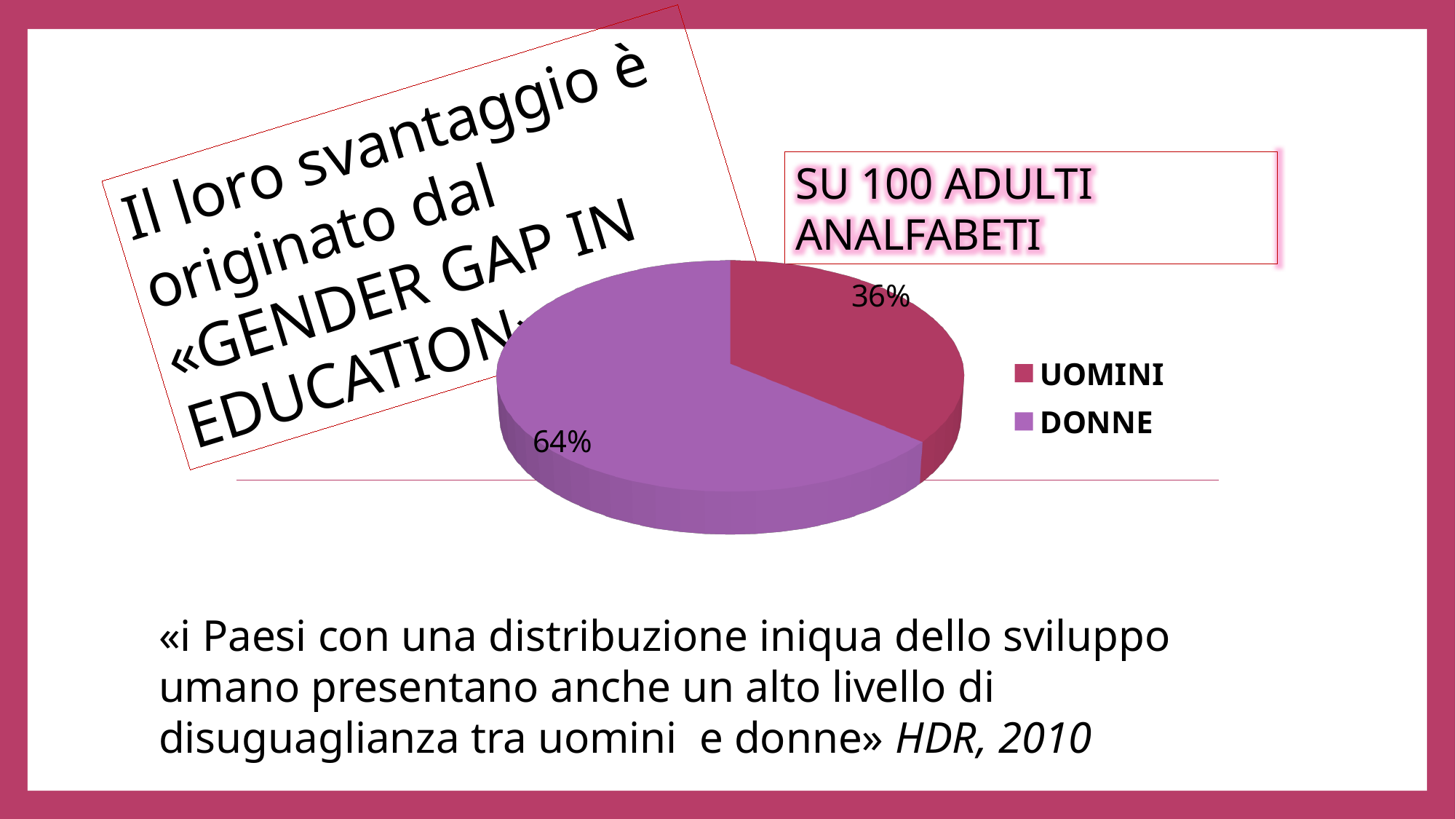
Which slice is larger, UOMINI or DONNE? DONNE How many categories does the pie chart show? 2 What percentage of the pie chart is labelled DONNE? 64% Which category has the largest slice of the pie chart? DONNE What is the title shown above the pie chart? SU 100 ADULTI ANALFABETI What is the difference in percentage points between the DONNE and UOMINI slices? 28 What colour is the DONNE slice in the pie chart? purple What percentage of the pie chart is labelled UOMINI? 36% What kind of chart is shown on the slide? pie chart How many entries does the legend list? 2 Which category has the smallest slice of the pie chart? UOMINI